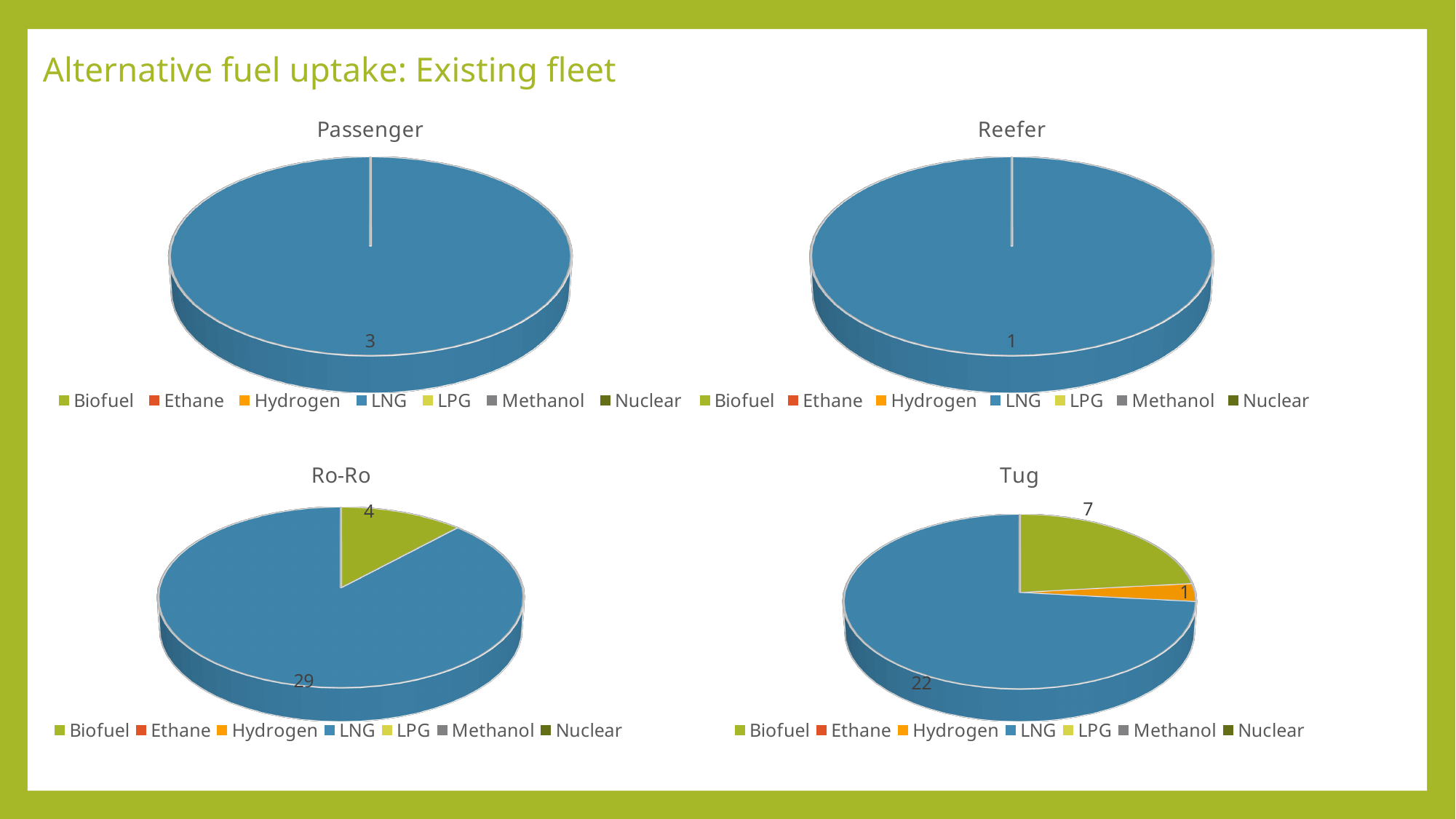
What kind of chart is the Passenger chart? pie chart In the Tug chart, what is the total of all slices? 30 In the Tug chart, which fuel has the largest slice? LNG In the Tug chart, which fuel has the smallest slice? Hydrogen In the Ro-Ro chart, what is the difference between the LNG value and the Biofuel value? 25 In the Tug chart, is the value for Biofuel larger or smaller than the value for LNG? smaller In the Reefer chart, what is the value for LNG? 1 In the Tug chart, what is the value for Hydrogen? 1 In the Passenger chart, what is the value for LNG? 3 How many entries does the legend of the Ro-Ro chart list? 7 In the Ro-Ro chart, what is the value for Biofuel? 4 In the Ro-Ro chart, what is the value for LNG? 29